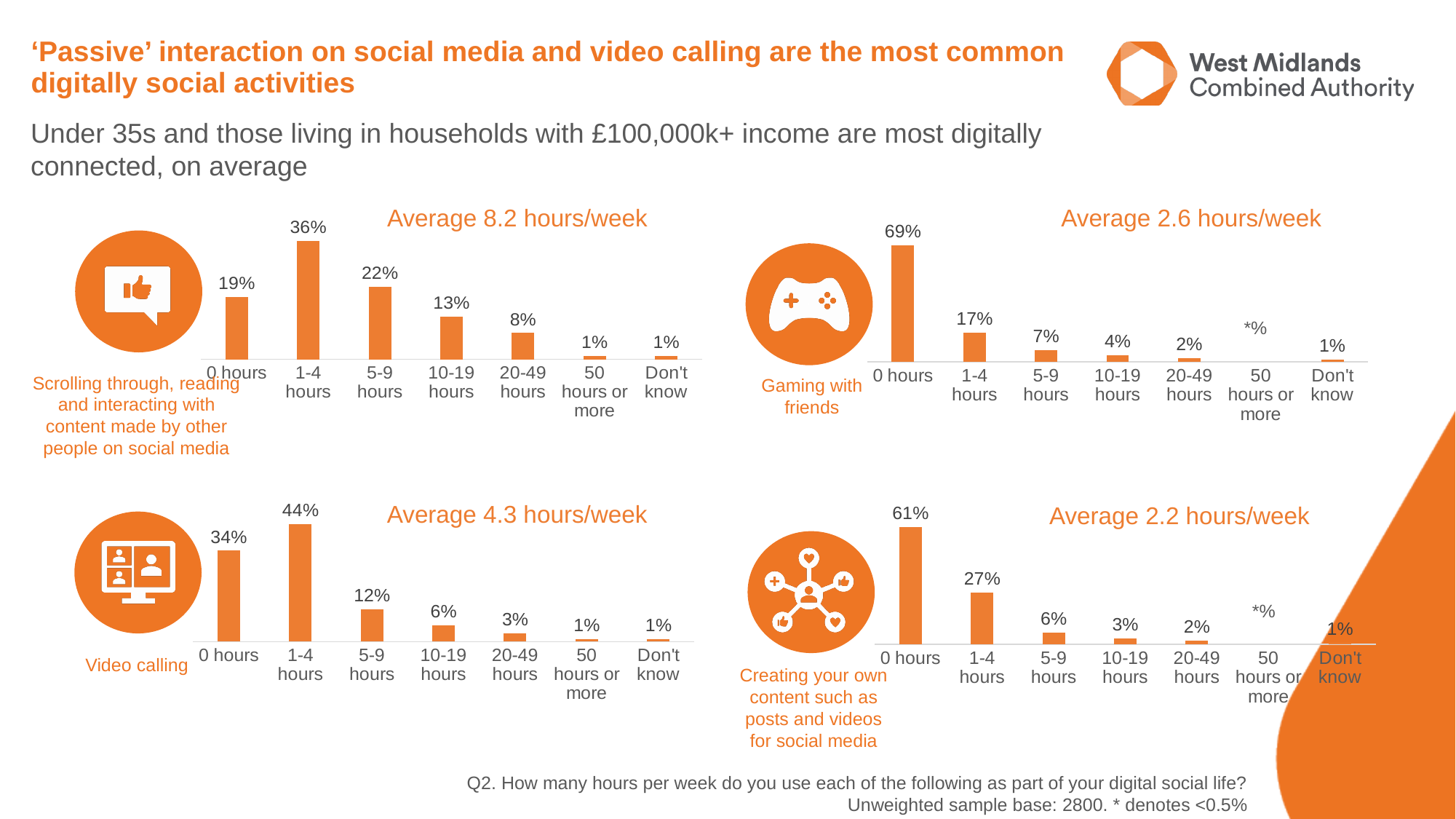
In the 'Scrolling through, reading and interacting with content made by other people on social media' chart, what percentage is shown for 1-4 hours? 36% In the 'Video calling' chart, what is the difference between the 1-4 hours and 0 hours values? 10% In the 'Creating your own content such as posts and videos for social media' chart, what percentage is shown for 1-4 hours? 27% In the 'Creating your own content such as posts and videos for social media' chart, which is larger: the value for 5-9 hours or the value for 10-19 hours? 5-9 hours In the 'Video calling' chart, what percentage is shown for 5-9 hours? 12% In the 'Video calling' chart, which category has the highest value? 1-4 hours In the 'Gaming with friends' chart, what percentage is shown for 0 hours? 69% What type of chart is used for 'Video calling'? Bar chart In the 'Scrolling through, reading and interacting with content made by other people on social media' chart, what is the difference between the 1-4 hours and 5-9 hours values? 14% What average hours per week is stated above the 'Scrolling through, reading and interacting with content made by other people on social media' chart? Average 8.2 hours/week How many categories are shown on the x axis of the 'Gaming with friends' chart? 7 In the 'Gaming with friends' chart, which category has the highest value? 0 hours